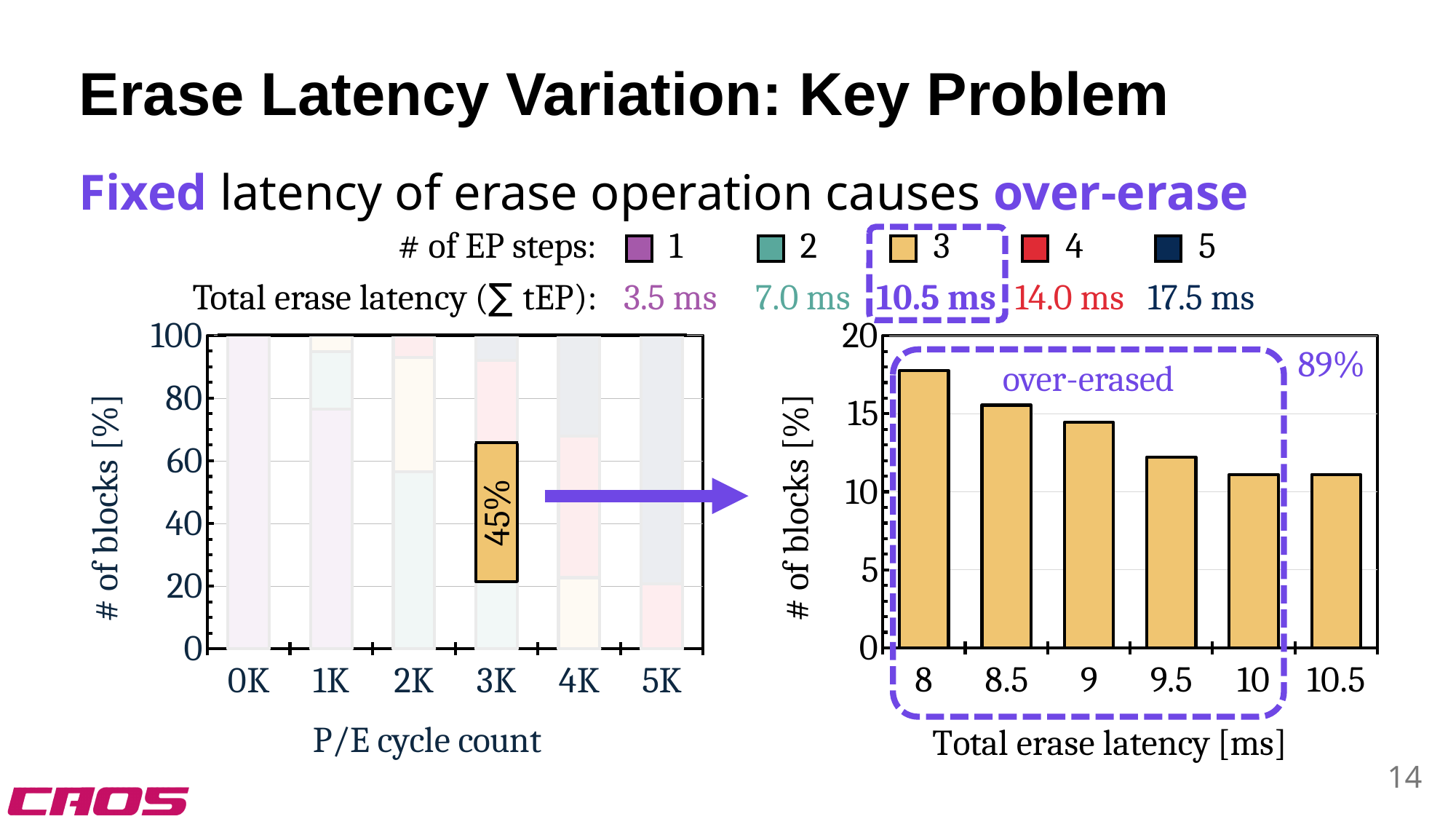
On the right chart (Total erase latency), what percentage is annotated next to the dashed 'over-erased' box? 89% On the right chart (Total erase latency), do the values rise or fall from 8 ms to 10 ms? fall On the left chart (P/E cycle count), how many P/E cycle count categories are shown on the x axis? 6 How many series (# of EP steps) does the legend list? 5 On the right chart (Total erase latency), is the value for 8 ms greater or less than 15? greater On the right chart (Total erase latency), is the value for 9.5 ms greater or less than 15? less On the right chart (Total erase latency), which has a larger # of blocks: 8 ms or 9.5 ms? 8 ms On the right chart (Total erase latency), is the value for 10 ms greater or less than 10? greater What kind of chart is the left chart (P/E cycle count)? stacked bar chart On the left chart (P/E cycle count), what percentage is printed on the highlighted segment at 3K? 45% What kind of chart is the right chart (Total erase latency)? bar chart On the right chart (Total erase latency), which total erase latency has the highest # of blocks? 8